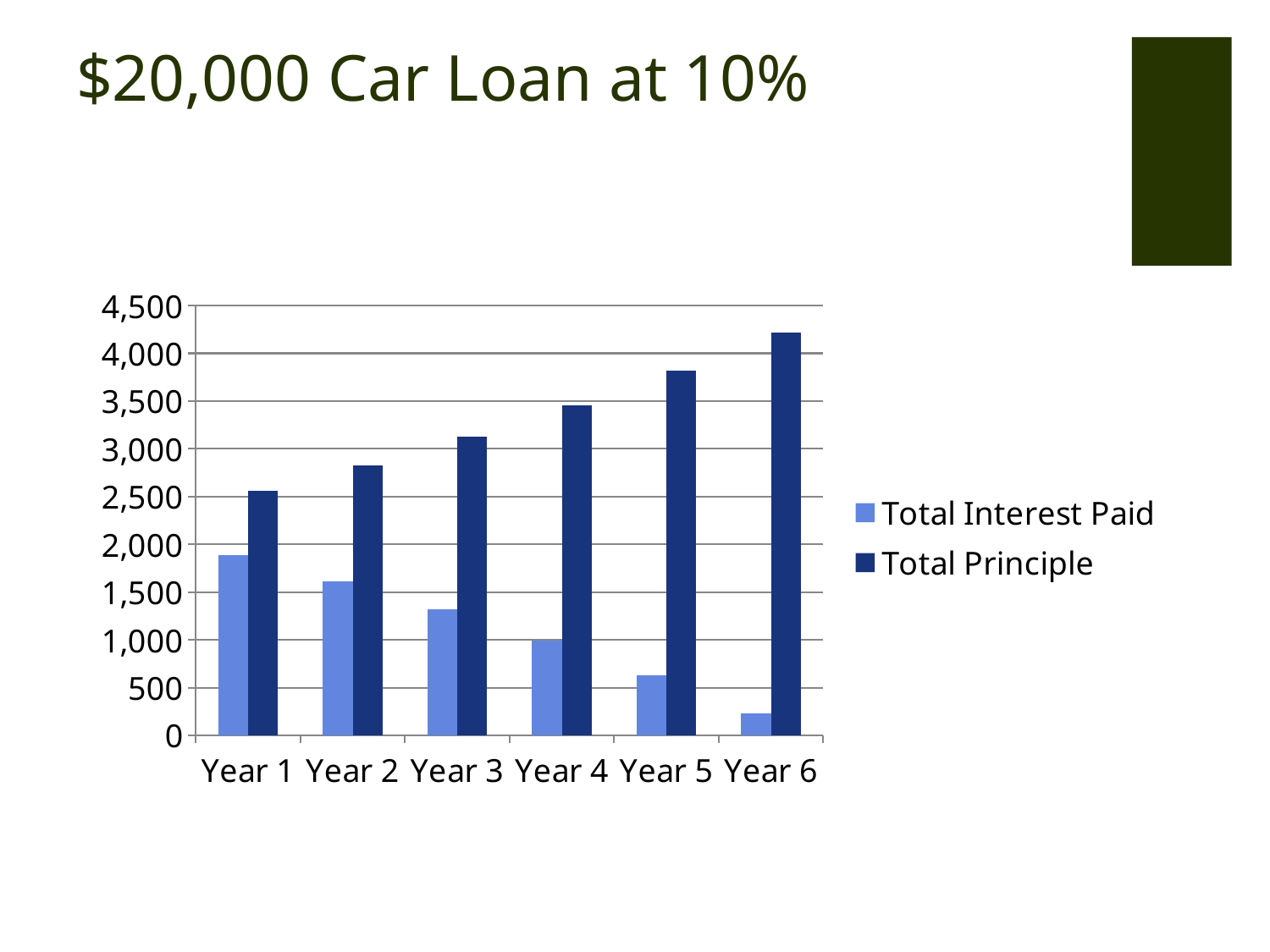
Does Total Principle rise or fall from Year 1 to Year 6? rise How many series does the legend list? 2 Which year has the highest Total Principle? Year 6 What is the title of the slide? $20,000 Car Loan at 10% Which year has the lowest Total Interest Paid? Year 6 How many years are shown on the x axis? 6 Which is larger in Year 3, Total Interest Paid or Total Principle? Total Principle Is the Total Principle for Year 6 greater or less than 4,000? greater What kind of chart is shown on the slide? bar chart Is the Total Interest Paid for Year 6 greater or less than 500? less Which year has the highest Total Interest Paid? Year 1 Does Total Interest Paid rise or fall from Year 1 to Year 6? fall